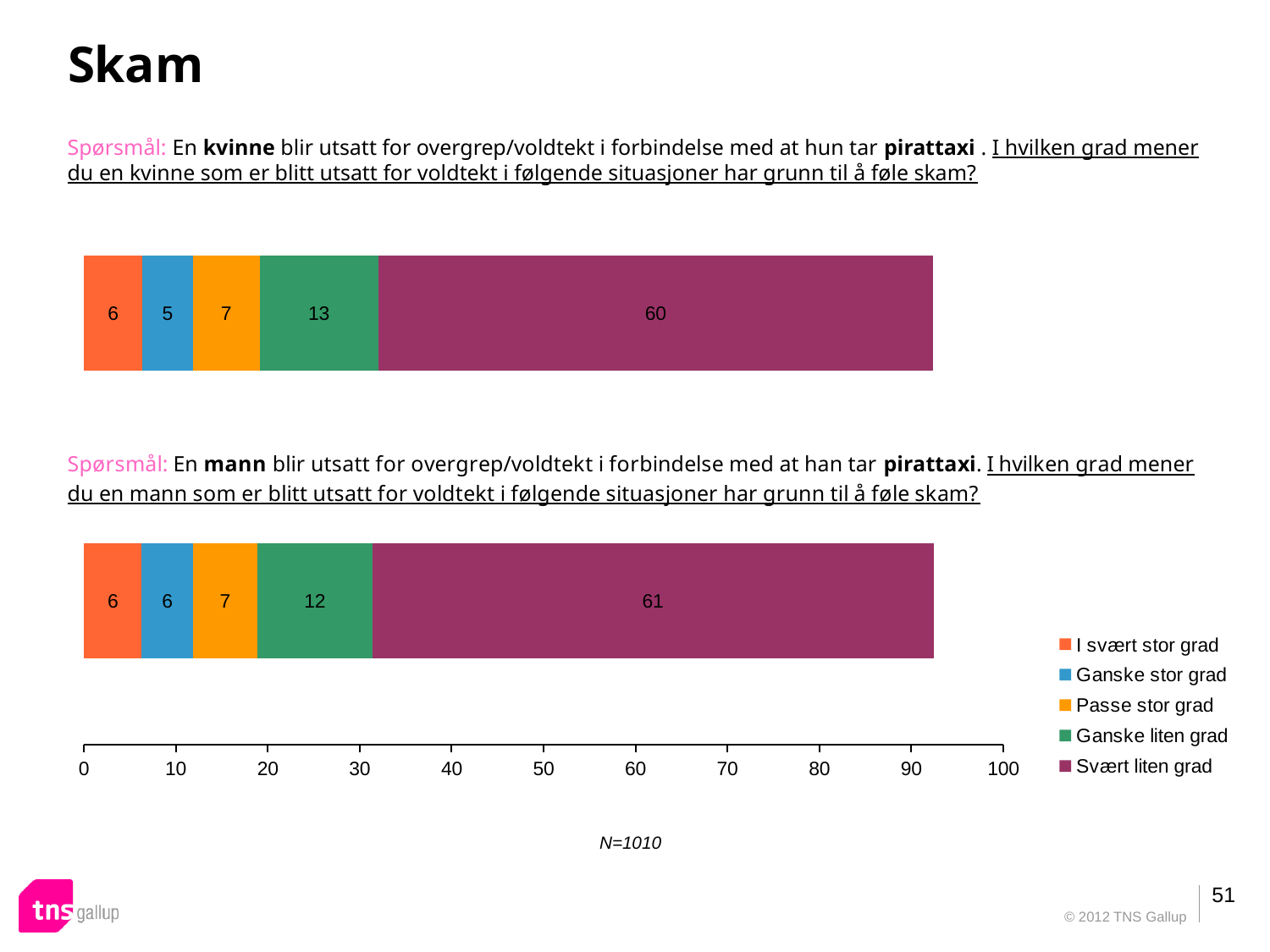
In the top chart (about a woman), what is the value for 'Ganske liten grad'? 13 What is the total of the stacked bar in the bottom chart (about a man)? 92 In the top chart (about a woman), which category has the lowest value? Ganske stor grad What is the total of the stacked bar in the top chart (about a woman)? 91 In the bottom chart (about a man), what is the difference between 'Svært liten grad' and 'Ganske liten grad'? 49 How many series does the legend list? 5 In the top chart (about a woman taking a pirate taxi), what is the value for 'Svært liten grad'? 60 In the bottom chart (about a man), what is the value for 'Ganske stor grad'? 6 Which is larger: 'Svært liten grad' in the top chart (woman) or 'Svært liten grad' in the bottom chart (man)? Bottom chart (man), 61 In the top chart (about a woman), which category has the highest value? Svært liten grad What kind of chart is shown on the slide? Stacked bar chart In the bottom chart (about a man taking a pirate taxi), what is the value for 'Svært liten grad'? 61